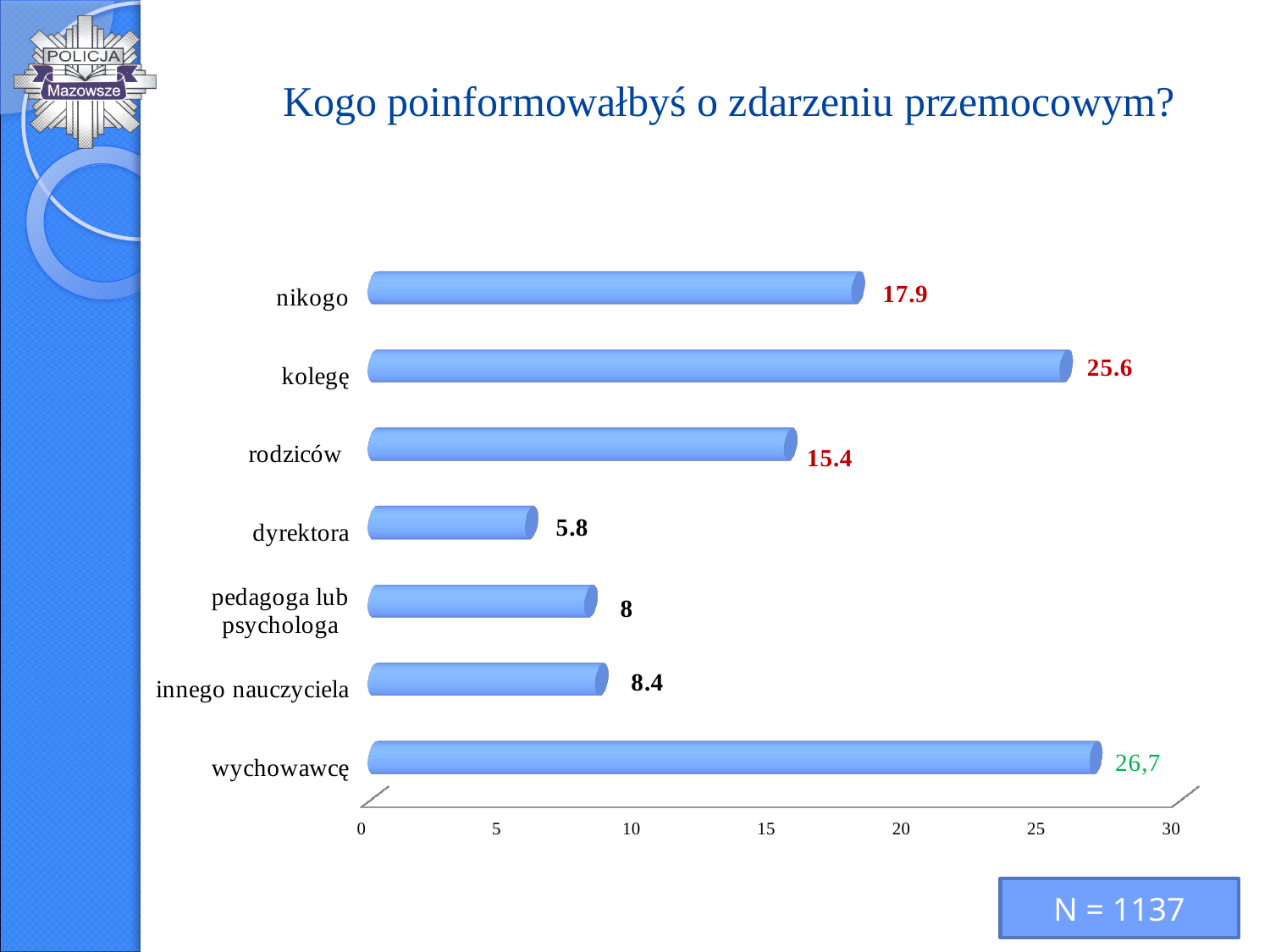
Which is larger, the value for "innego nauczyciela" or the value for "pedagoga lub psychologa"? innego nauczyciela What is the value for "wychowawcę"? 26,7 What is the value for "dyrektora"? 5.8 What kind of chart is shown on the slide? bar chart What is the title of the chart? Kogo poinformowałbyś o zdarzeniu przemocowym? What is the difference between the values for "nikogo" and "rodziców"? 2.5 How many categories are shown in the chart? 7 Is the value for "rodziców" greater or less than 15? greater Which category has the highest value? wychowawcę What is the value for "kolegę"? 25.6 Which category has the lowest value? dyrektora What is the value for "pedagoga lub psychologa"? 8